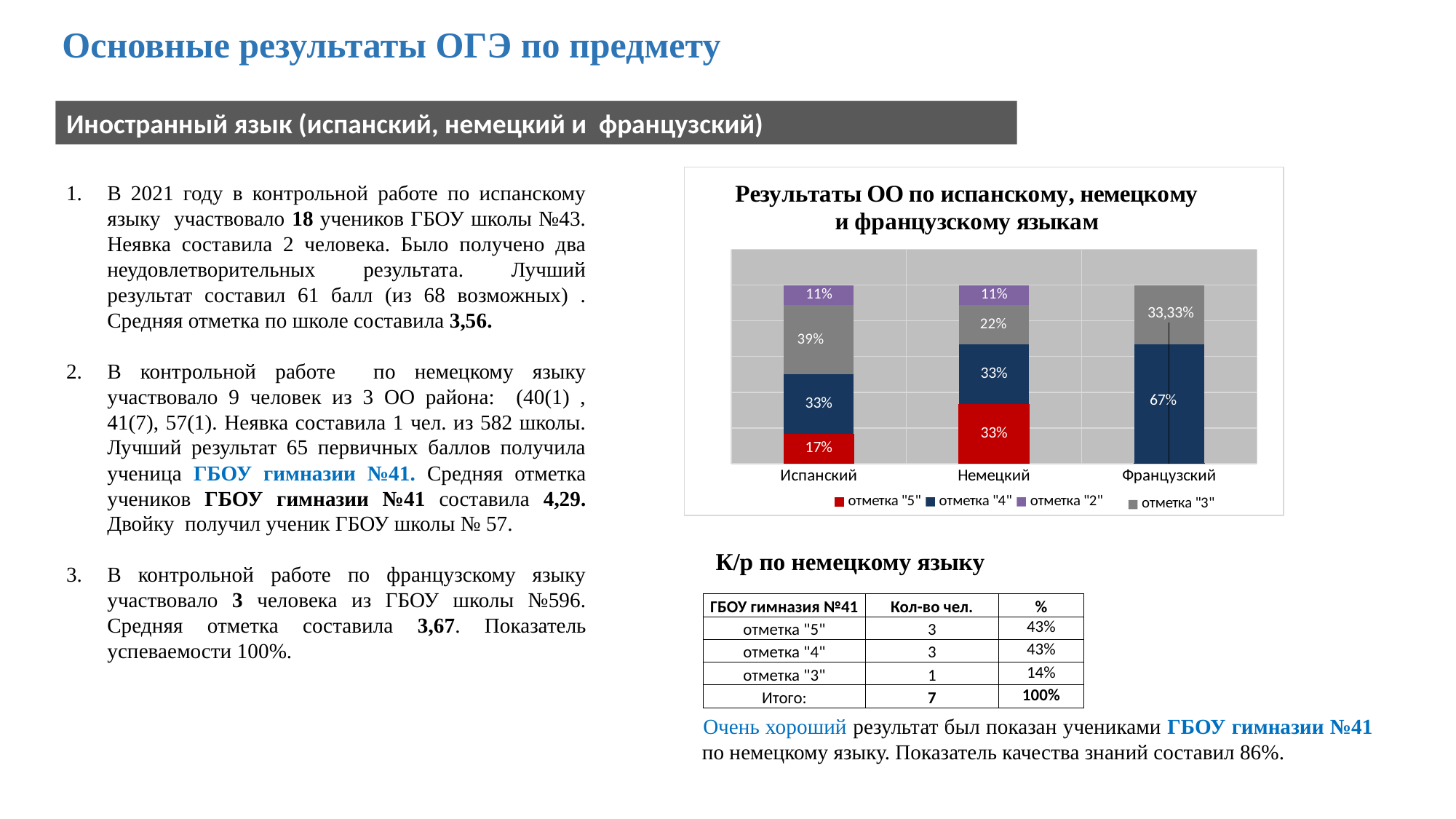
In the chart, what is the difference between the share of отметка "5" for Немецкий and for Испанский? 16% In the chart, what is the value for отметка "2" for Испанский? 11% In the chart, which language has the highest share of отметка "5"? Немецкий In the chart, what is the value for отметка "4" for Французский? 67% How many series does the chart's legend list? 4 In the chart, which is larger: the share of отметка "3" for Испанский or for Немецкий? Испанский In the chart, what is the value for отметка "5" for Испанский? 17% In the chart, what is the difference between the share of отметка "3" for Испанский and for Немецкий? 17% In the chart, what is the value for отметка "3" for Немецкий? 22% How many languages (categories) are shown on the x axis of the chart? 3 In the chart, what is the value for отметка "3" for Французский? 33,33% What kind of chart is shown on the slide? Stacked bar chart